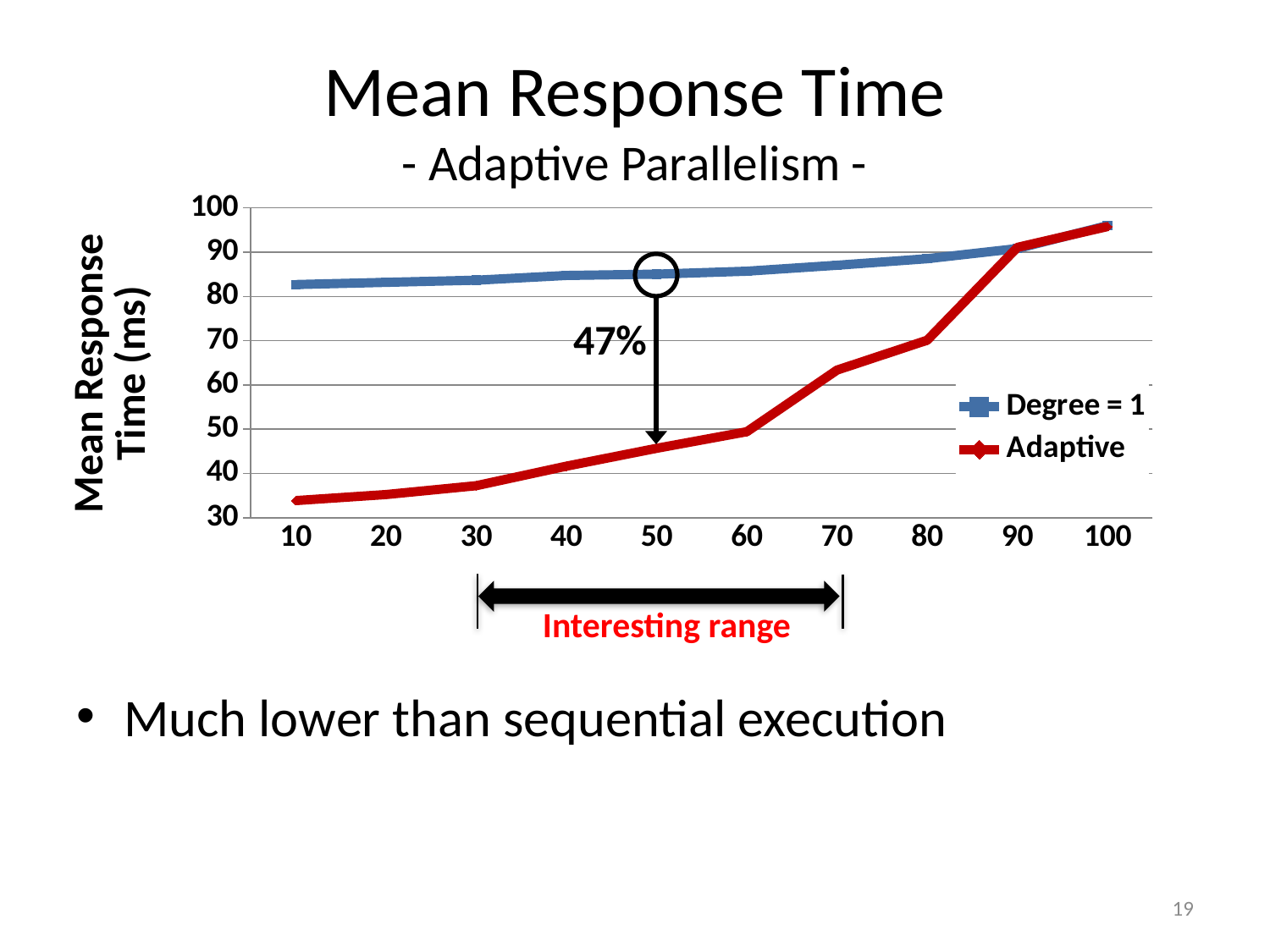
Does the Adaptive series rise or fall as the x-axis value increases from 10 to 100? rise Is the Degree = 1 value at x = 10 greater or less than 80? greater What kind of chart is shown on the slide? line chart What are the two series named in the legend? Degree = 1 and Adaptive Is the Degree = 1 value at x = 100 greater or less than 90? greater At x = 10, which series has the lower mean response time? Adaptive Is the Adaptive value at x = 50 greater or less than 50? less How many points are plotted along the x axis for each series? 10 What percentage is annotated between the two lines at x = 50? 47% At x = 50, which series has the higher mean response time, Degree = 1 or Adaptive? Degree = 1 How many series does the legend list? 2